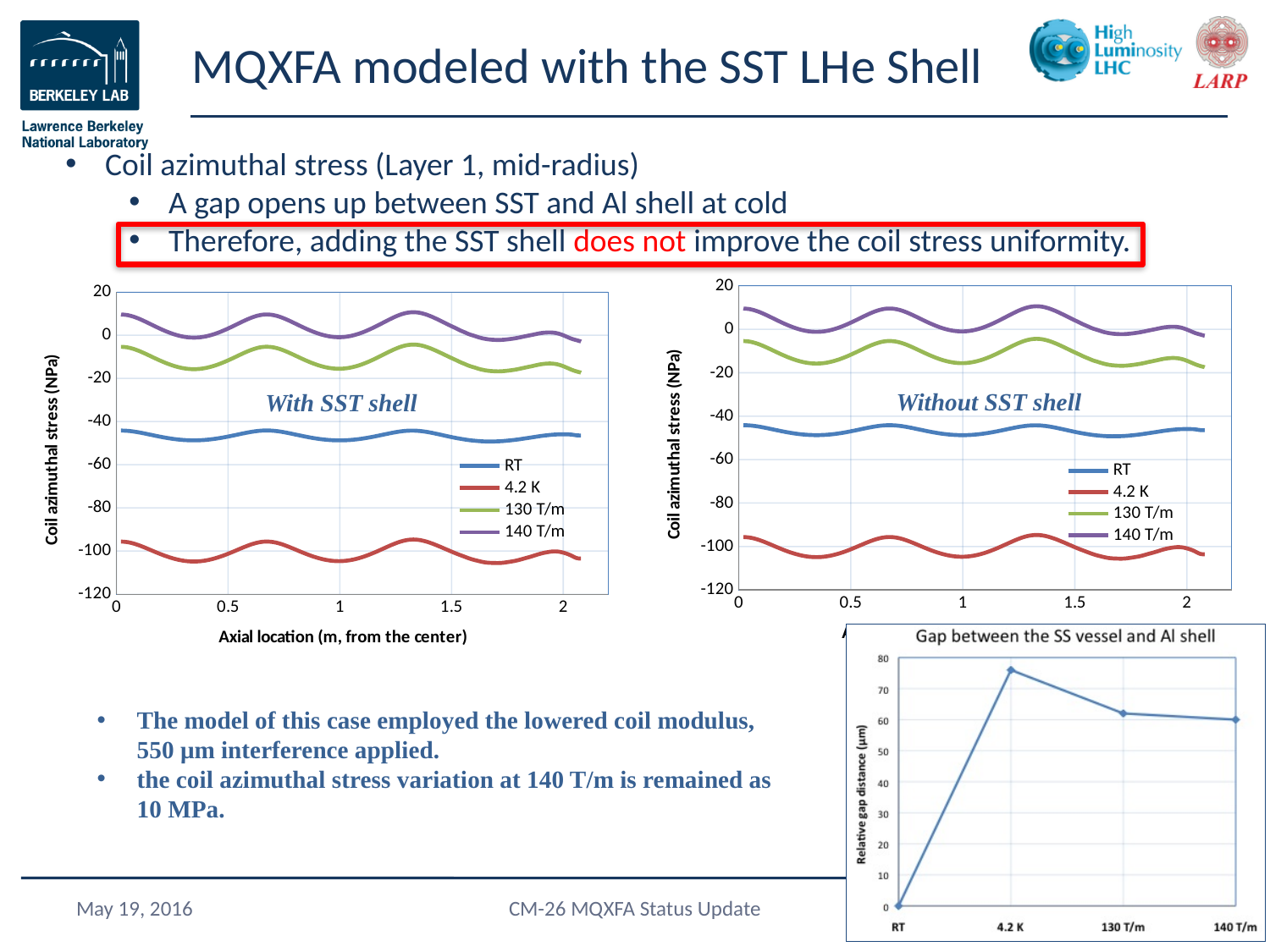
In the 'With SST shell' chart, which series has the highest coil azimuthal stress values? 140 T/m What kind of chart is the 'With SST shell' chart? line chart What is the x-axis label of the 'With SST shell' chart? Axial location (m, from the center) In the 'With SST shell' chart, is the value of the 4.2 K series at axial location 1 greater or less than -80? less In the 'Without SST shell' chart, which series has the lowest coil azimuthal stress values? 4.2 K In the 'Gap between the SS vessel and Al shell' chart, which category has the highest relative gap distance? 4.2 K In the 'Without SST shell' chart, is the value of the 140 T/m series at axial location 1.5 greater or less than -20? greater In the 'With SST shell' chart, is the value of the RT series at axial location 0.5 greater or less than -60? greater How many series does the legend of the 'With SST shell' chart list? 4 In the 'Gap between the SS vessel and Al shell' chart, how many categories are on the x axis? 4 What are the legend entries of the 'Without SST shell' chart? RT, 4.2 K, 130 T/m, 140 T/m